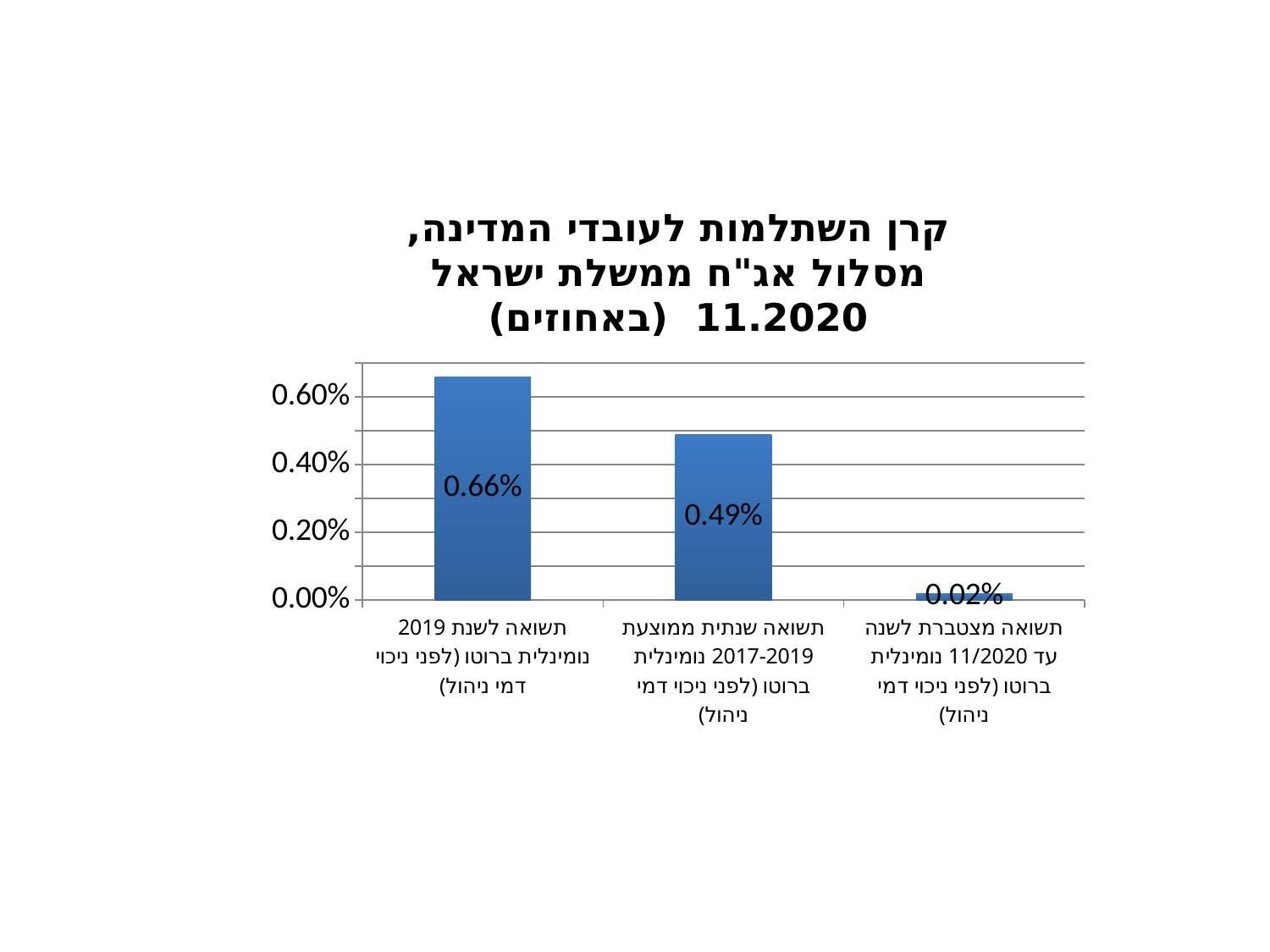
Do the values rise or fall from left to right along the x axis? fall Which category has the lowest value? תשואה מצטברת לשנה עד 11/2020 נומינלית ברוטו (לפני ניכוי דמי ניהול) What is the difference between the value for 2019 (תשואה לשנת 2019) and the average annual return for 2017-2019 (תשואה שנתית ממוצעת 2017-2019)? 0.17% What is the value for the category "תשואה מצטברת לשנה עד 11/2020 נומינלית ברוטו (לפני ניכוי דמי ניהול)"? 0.02% What is the difference between the average annual return for 2017-2019 (תשואה שנתית ממוצעת 2017-2019) and the cumulative return to 11/2020 (תשואה מצטברת לשנה עד 11/2020)? 0.47% What kind of chart is shown on the slide? bar chart Which category has the highest value? תשואה לשנת 2019 נומינלית ברוטו (לפני ניכוי דמי ניהול) How many categories are shown in the chart? 3 Which is larger: the value for 2019 (תשואה לשנת 2019) or the cumulative return to 11/2020 (תשואה מצטברת לשנה עד 11/2020)? תשואה לשנת 2019 What is the value for the category "תשואה לשנת 2019 נומינלית ברוטו (לפני ניכוי דמי ניהול)"? 0.66% What is the value for the category "תשואה שנתית ממוצעת 2017-2019 נומינלית ברוטו (לפני ניכוי דמי ניהול)"? 0.49% Is the value for the average annual return 2017-2019 (תשואה שנתית ממוצעת 2017-2019) greater or less than 0.40%? greater